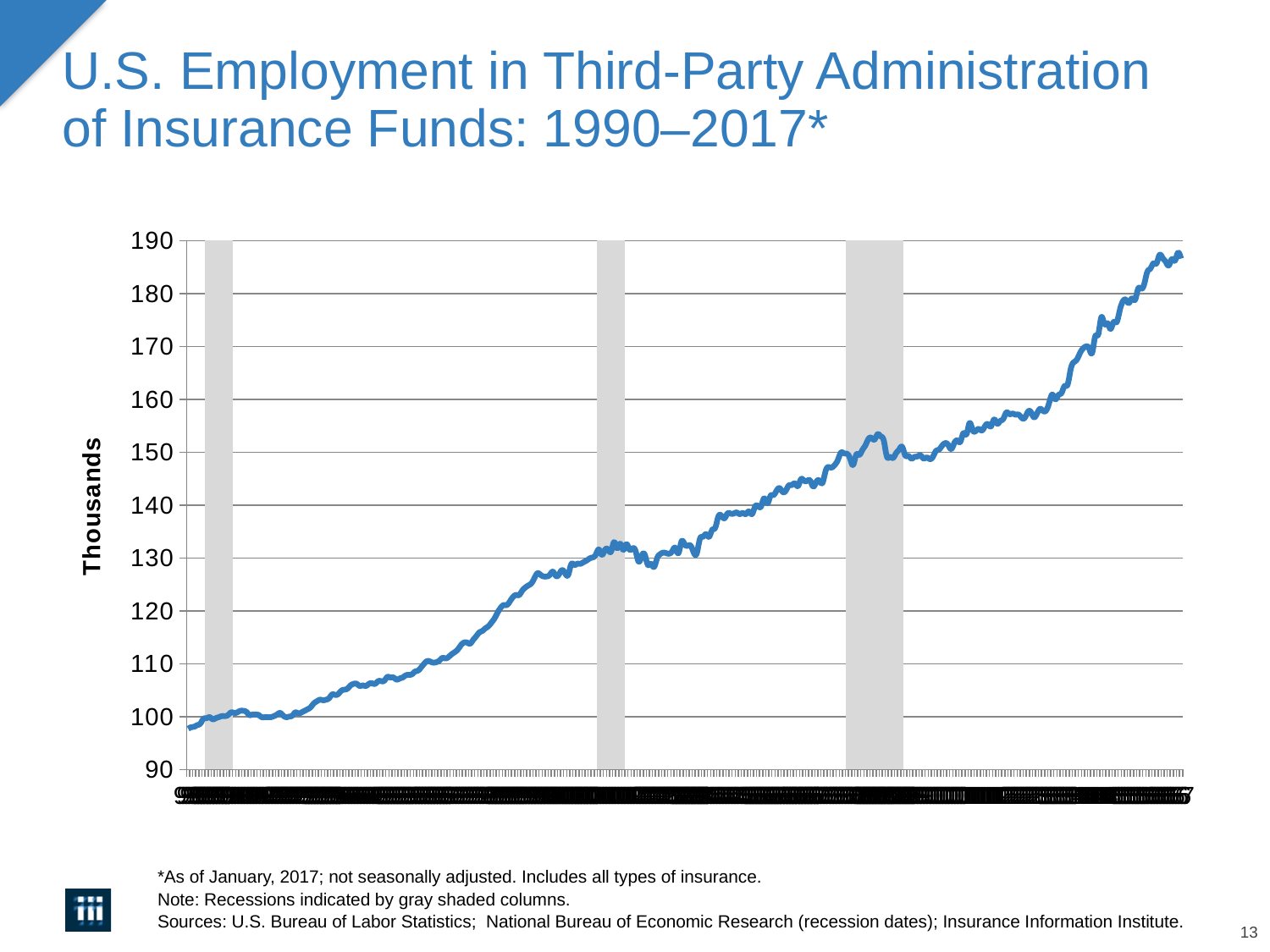
Is the highest point of the line greater or less than 170? greater Is the value of the line during the third (rightmost) gray shaded recession column greater or less than 140? greater How many gray shaded recession columns appear on the chart? 3 What kind of chart is shown on the slide? line chart Is the value of the line during the first (leftmost) gray shaded recession column greater or less than 120? less Overall, do the values rise or fall from the left of the x axis to the right? rise What is the label on the vertical axis of the chart? Thousands